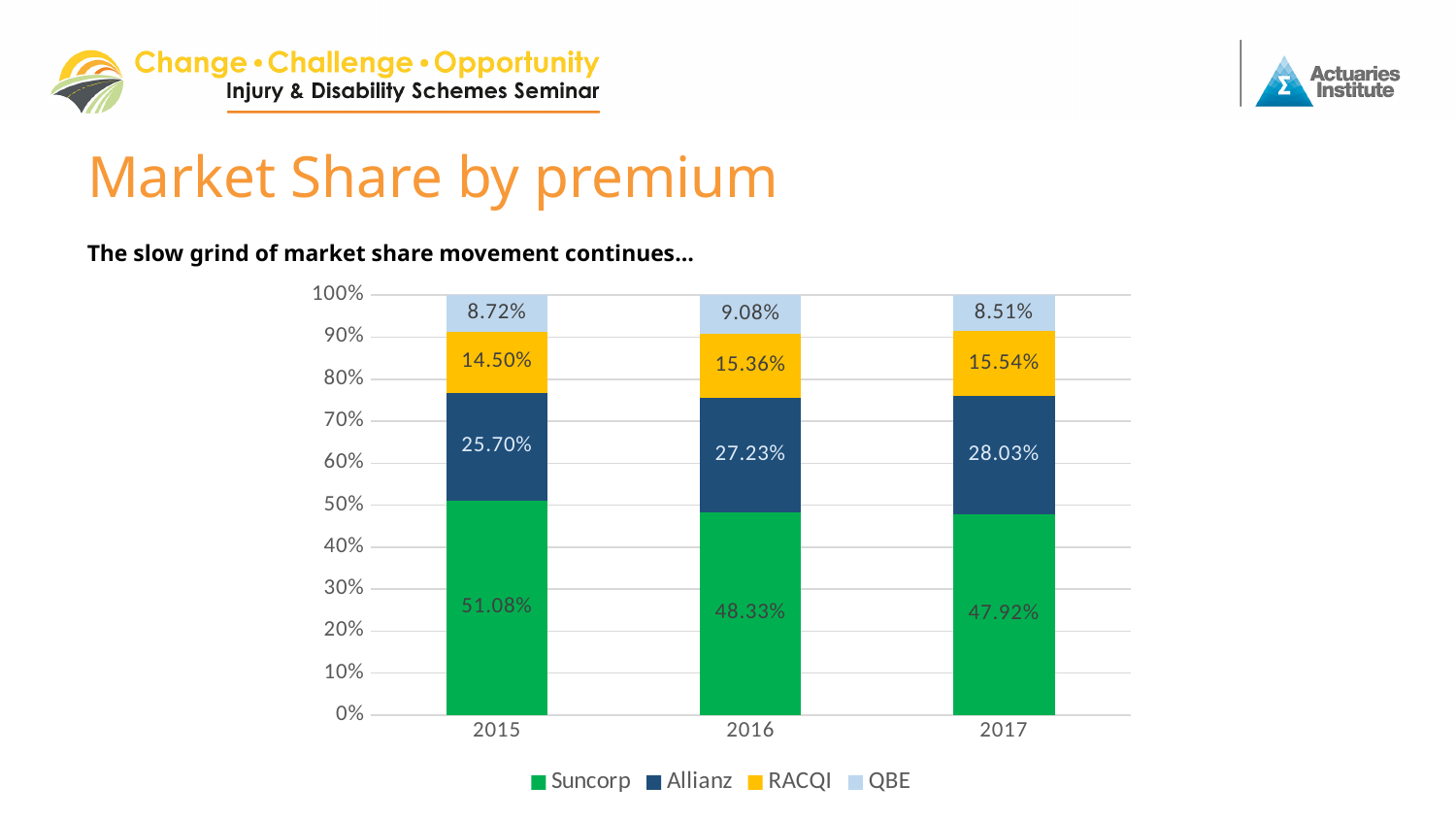
What is Suncorp's market share in 2015? 51.08% Which is larger: RACQI's share in 2016 or RACQI's share in 2015? RACQI's share in 2016 What is QBE's market share in 2016? 9.08% What is Allianz's market share in 2017? 28.03% Does Suncorp's market share rise or fall from 2015 to 2017? Fall What kind of chart is shown on the slide? Stacked bar chart In which year is QBE's market share lowest? 2017 How many series does the legend list? 4 By how many percentage points did Allianz's market share change from 2015 to 2017? 2.33 percentage points In which year is Suncorp's market share highest? 2015 What is RACQI's market share in 2017? 15.54% How many years are shown on the x axis? 3